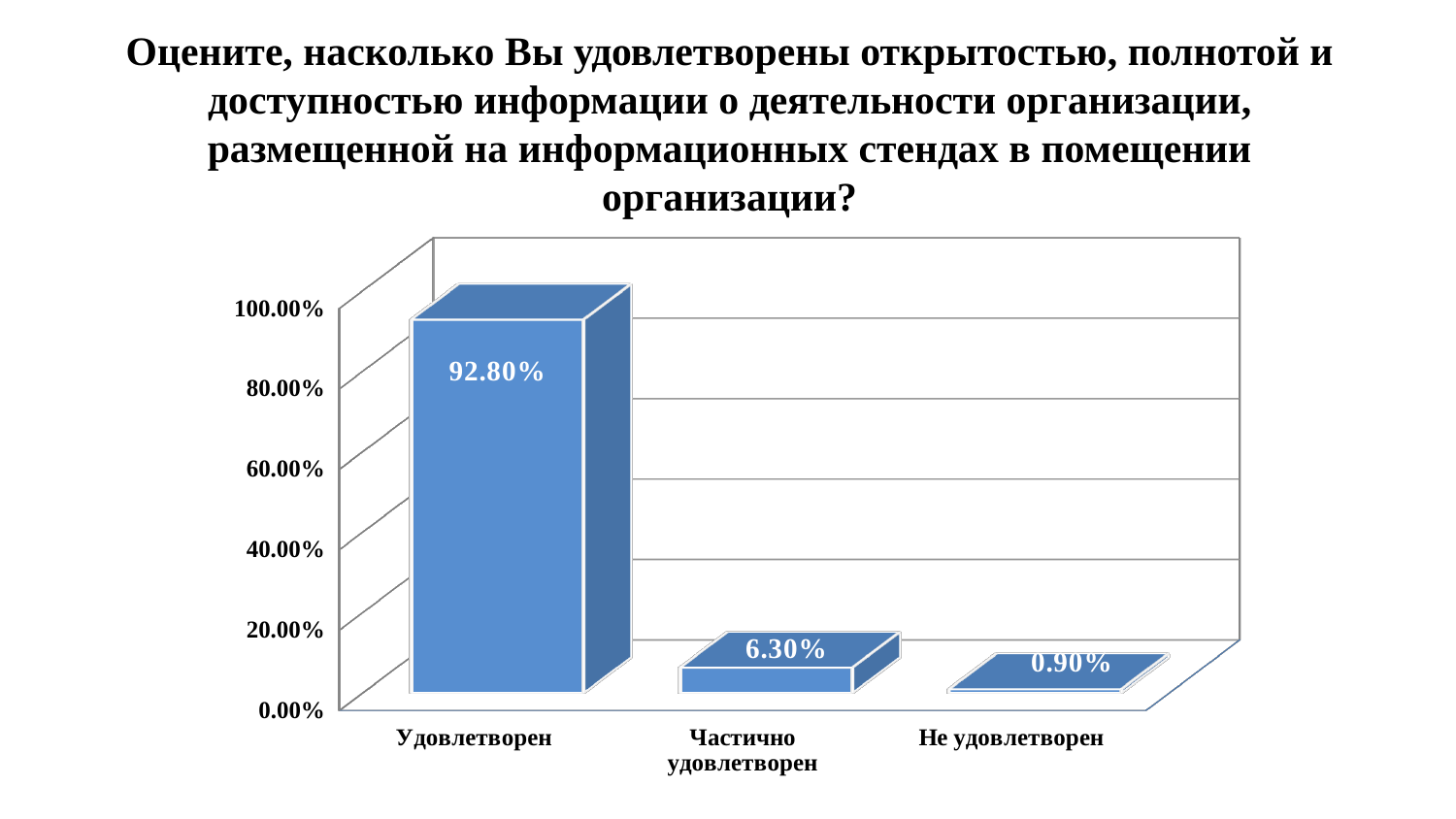
What is the difference between the values for Частично удовлетворен and Не удовлетворен? 5.40% What kind of chart is shown on the slide? bar chart What is the value for Удовлетворен? 92.80% Is the value for Удовлетворен greater or less than 80.00%? greater How many categories are shown on the chart? 3 Which category has the highest value? Удовлетворен Which category has the lowest value? Не удовлетворен What is the value for Не удовлетворен? 0.90% What is the difference between the values for Удовлетворен and Частично удовлетворен? 86.50% Do the values rise or fall from left to right along the x axis? fall Which is larger, the value for Частично удовлетворен or the value for Не удовлетворен? Частично удовлетворен What is the value for Частично удовлетворен? 6.30%